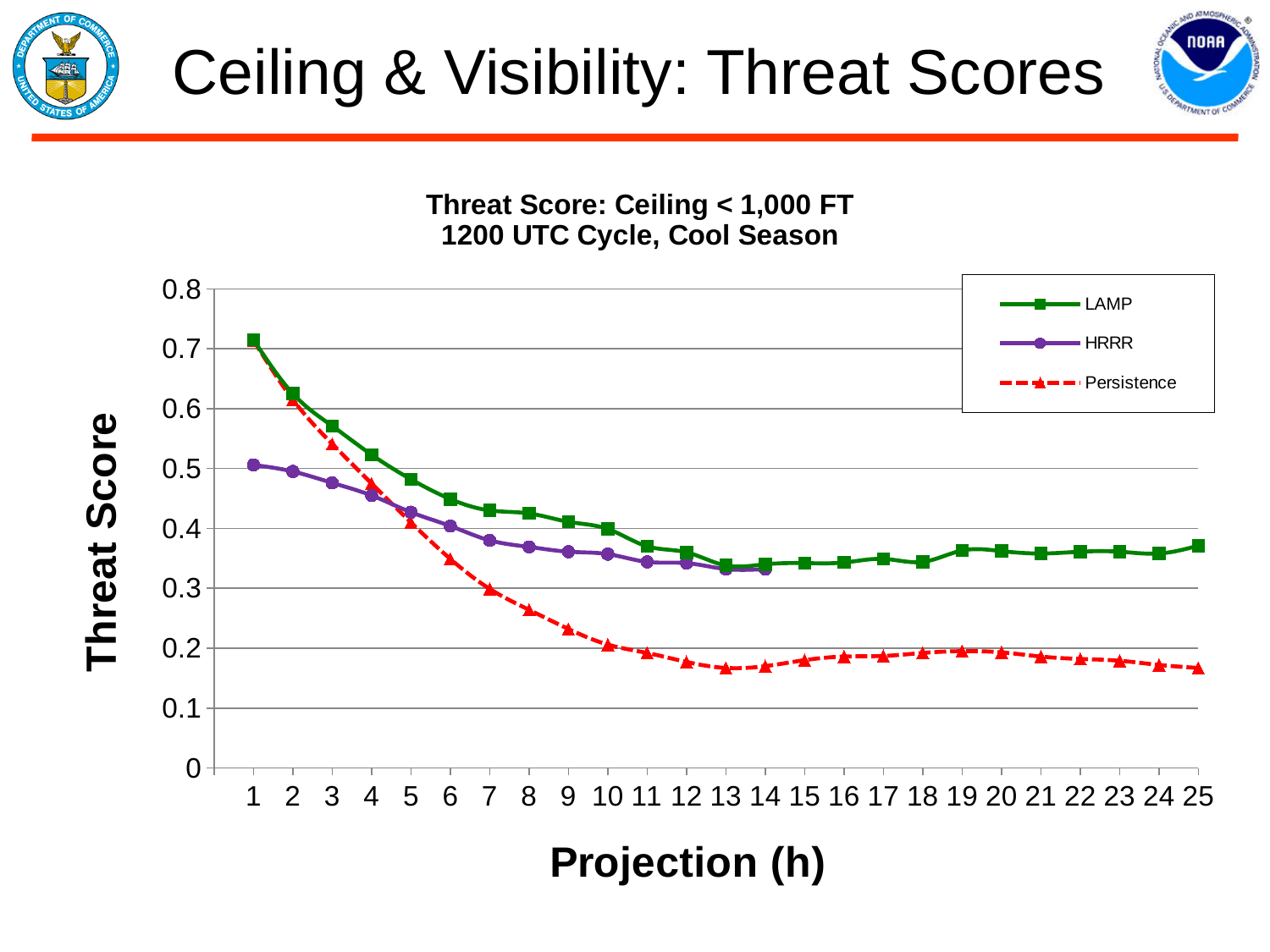
Does the LAMP threat score rise or fall from projection 1 to projection 13? fall Is the LAMP threat score at projection 25 greater or less than 0.3? greater How many projection hours are shown on the x axis? 25 Which series has the lowest threat score at projection 13? Persistence Up to what projection hour does the HRRR series extend? 14 At projection 3, which series has the larger threat score, HRRR or Persistence? Persistence Is the LAMP threat score at projection 1 greater or less than 0.6? greater How many series does the legend list? 3 Is the Persistence threat score at projection 13 greater or less than 0.2? less What kind of chart is shown on the slide? line chart Which series is drawn as a dashed red line? Persistence At projection 5, which series has the larger threat score, LAMP or HRRR? LAMP